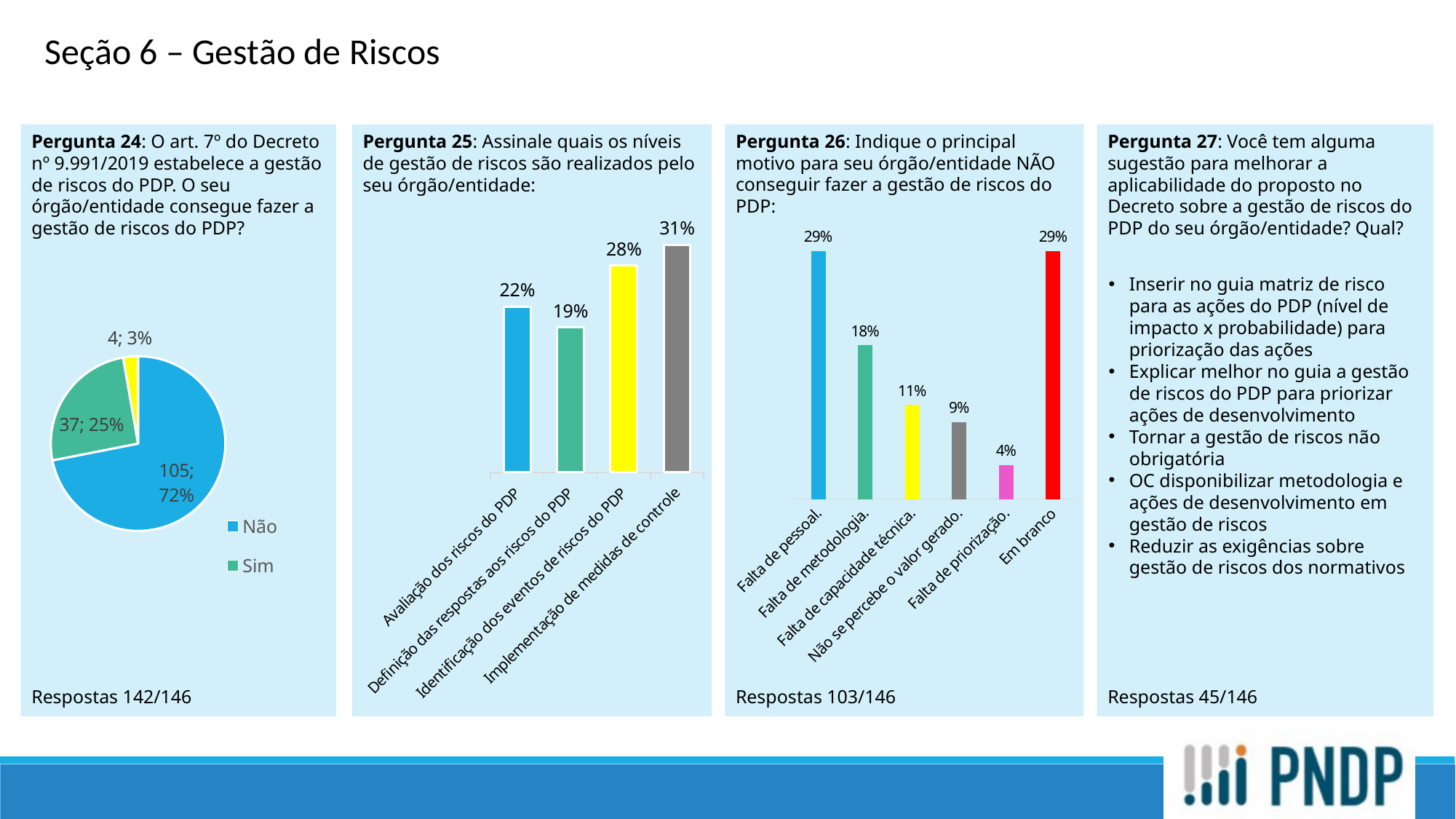
In the Pergunta 24 pie chart, what share of the pie does "Sim" represent? 25% In the Pergunta 26 bar chart, which category has the lowest value? Falta de priorização What kind of chart is used for Pergunta 24? Pie chart In the Pergunta 24 chart, how many entries does the legend list? 2 In the Pergunta 26 bar chart, what is the value for "Falta de metodologia"? 18% How many categories are plotted in the Pergunta 26 bar chart? 6 In the Pergunta 25 bar chart, which category has the lowest value? Definição das respostas aos riscos do PDP In the Pergunta 26 bar chart, which is larger: "Falta de capacidade técnica" or "Não se percebe o valor gerado"? Falta de capacidade técnica In the Pergunta 25 bar chart, what is the difference between "Identificação dos eventos de riscos do PDP" and "Avaliação dos riscos do PDP"? 6% In the Pergunta 25 bar chart, what is the value for "Implementação de medidas de controle"? 31% How many categories are plotted in the Pergunta 25 bar chart? 4 In the Pergunta 24 pie chart, what value and share are shown for the "Não" slice? 105; 72%